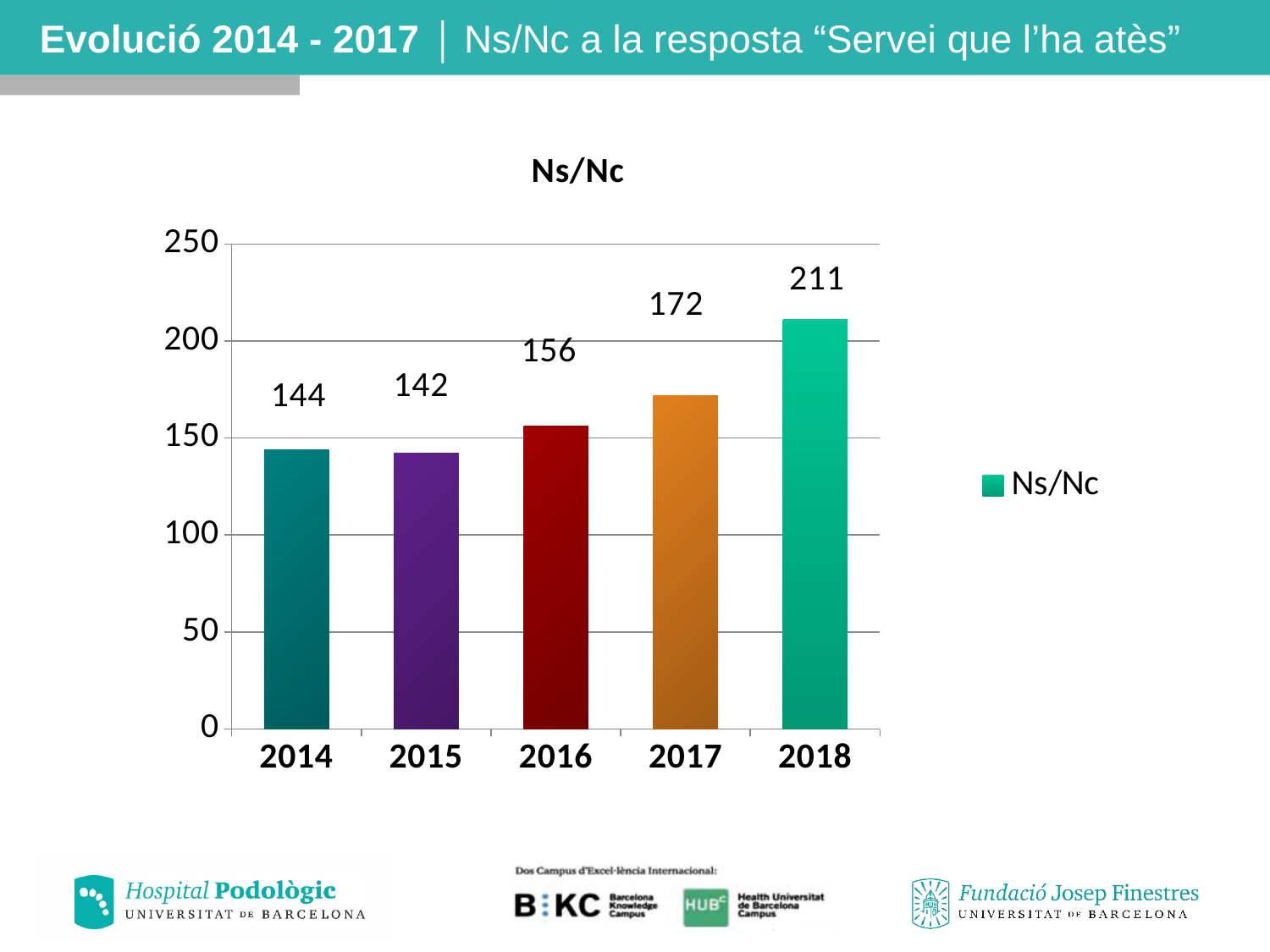
What is the Ns/Nc value for 2014? 144 How many series does the legend list? 1 Which year has the lowest Ns/Nc value? 2015 How many years are shown on the x axis of the chart? 5 What is the Ns/Nc value for 2018? 211 What is the difference between the Ns/Nc values for 2016 and 2015? 14 What is the Ns/Nc value for 2016? 156 What is the difference between the Ns/Nc values for 2018 and 2017? 39 Is the Ns/Nc value for 2018 greater or less than 200? greater Which year has the highest Ns/Nc value? 2018 Which is larger, the Ns/Nc value for 2014 or for 2017? 2017 What kind of chart is shown on the slide? Bar chart